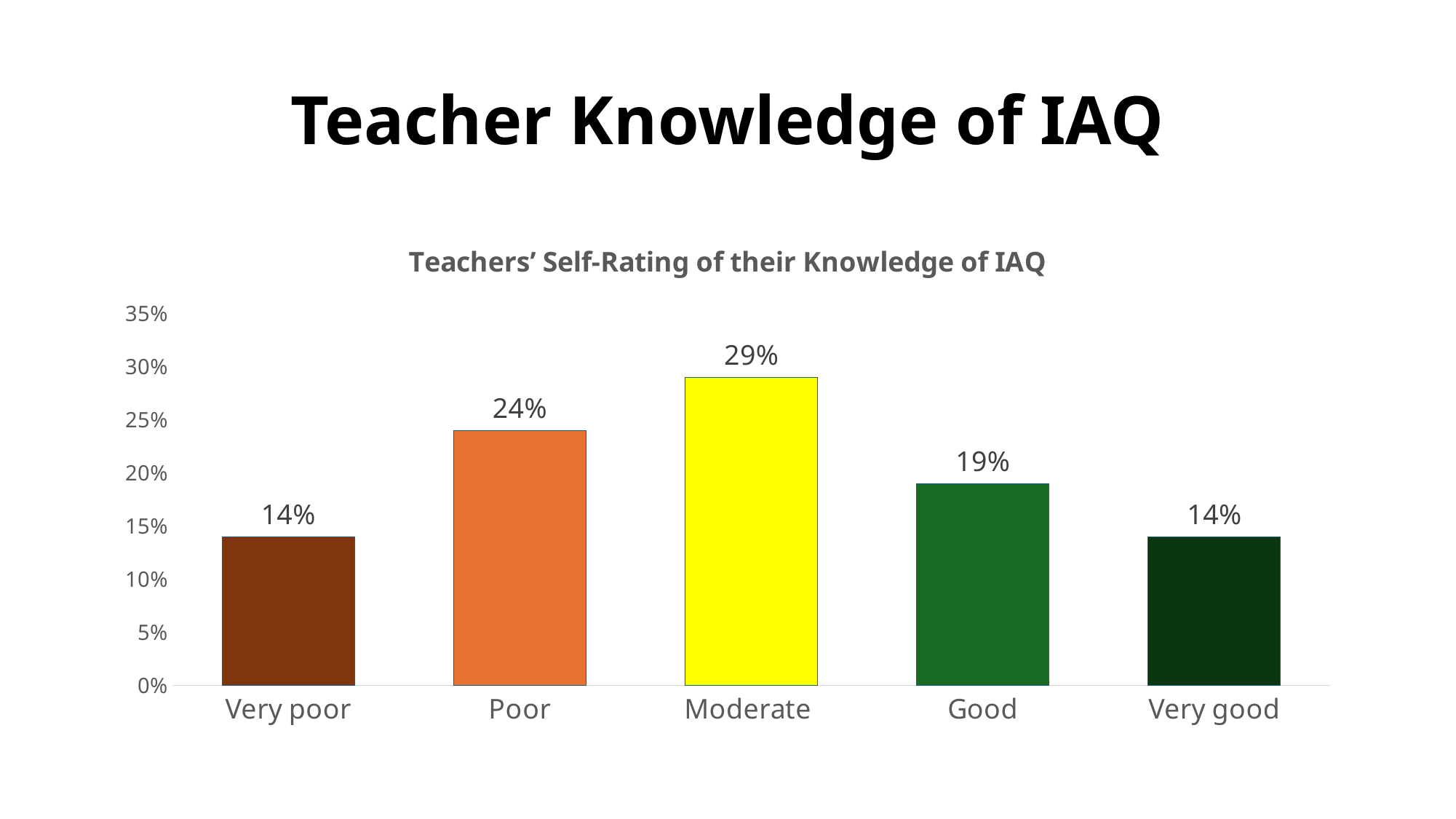
Which category has a larger percentage, Poor or Good? Poor What percentage of teachers rated their knowledge of IAQ as Moderate? 29% What is the difference in percentage points between the Moderate and Good categories? 10 Which self-rating category has the highest percentage of teachers? Moderate How many self-rating categories are shown on the chart? 5 What percentage of teachers rated their knowledge of IAQ as Poor? 24% What is the difference in percentage points between the Poor and Very poor categories? 10 Is the value for Moderate greater or less than 25%? greater What is the title of the chart? Teachers' Self-Rating of their Knowledge of IAQ What type of chart is used to show teachers' self-rating of their knowledge of IAQ? Bar chart What percentage of teachers rated their knowledge of IAQ as Good? 19% Which two categories share the same percentage value? Very poor and Very good